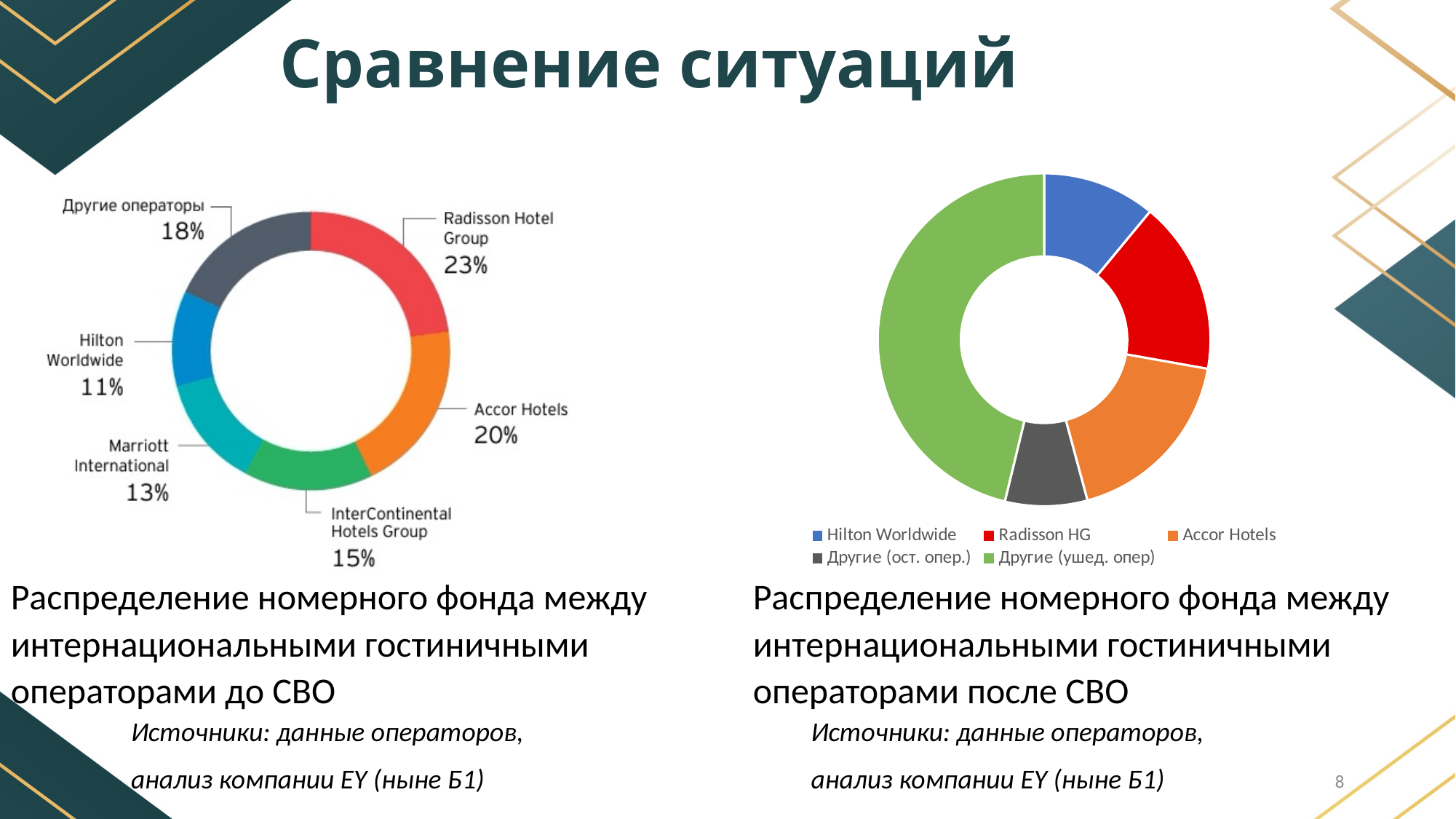
How many entries does the legend of the right chart (после СВО) list? 5 How many segments does the left chart (до СВО) have? 6 On the left chart (до СВО), what share of the room stock does Radisson Hotel Group hold? 23% On the left chart (до СВО), what is the difference between the shares of Accor Hotels and Marriott International? 7% On the left chart (до СВО), which operator has the smallest share? Hilton Worldwide On the left chart (до СВО), what is the value for InterContinental Hotels Group? 15% On the right chart (после СВО), which category has the largest segment? Другие (ушед. опер) On the left chart (до СВО), which operator has the largest share? Radisson Hotel Group On the left chart (до СВО), what is the value for Hilton Worldwide? 11% On the left chart (до СВО), which is larger: the share of Другие операторы or the share of InterContinental Hotels Group? Другие операторы On the right chart (после СВО), which colour represents Accor Hotels in the legend? Orange What type of chart is used on the right side of the slide (после СВО)? Donut (pie) chart